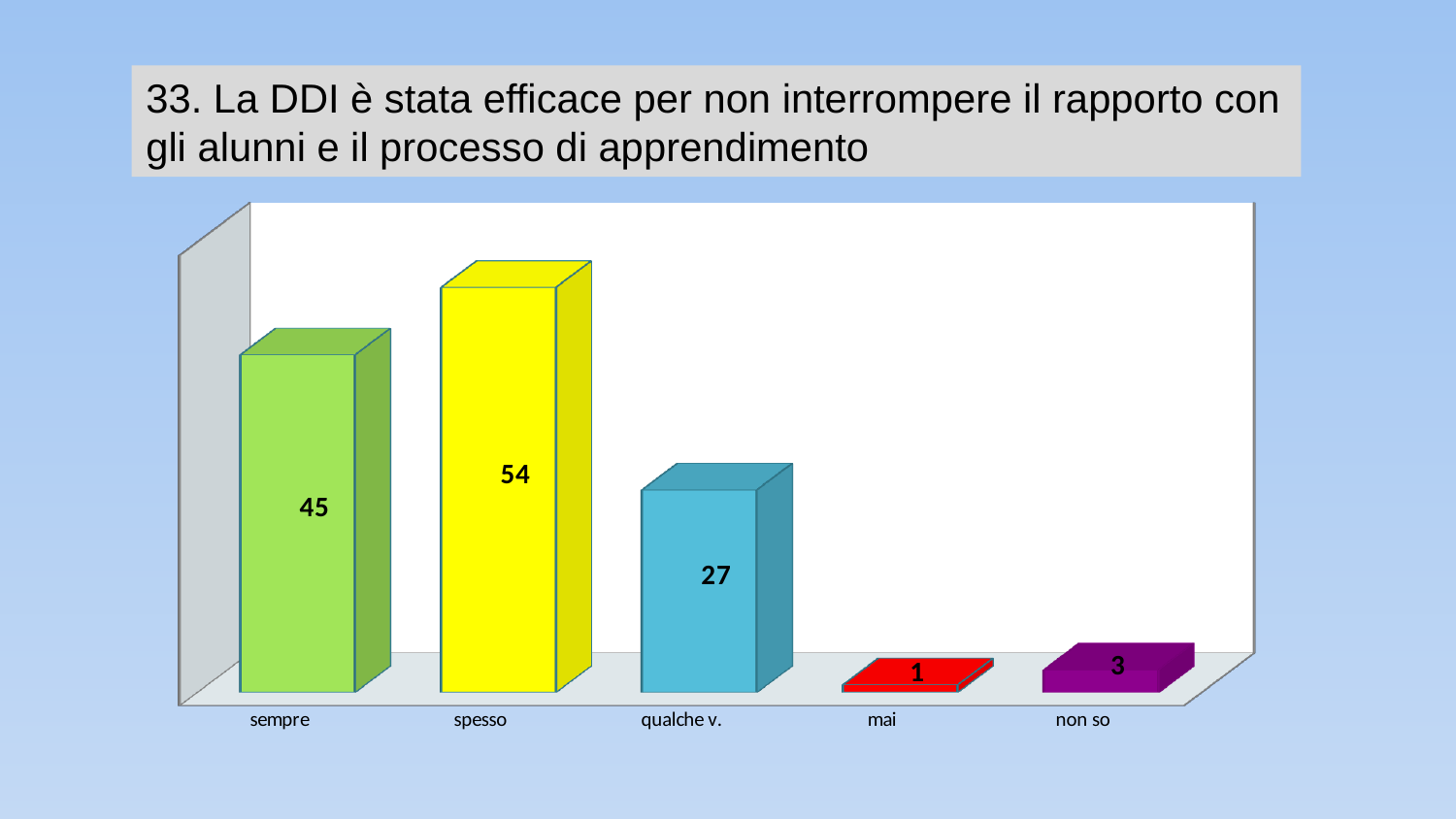
What is the value for "mai"? 1 Which is larger, the value for "sempre" or the value for "qualche v."? sempre What kind of chart is shown on the slide? bar chart What colour is the bar for "spesso"? yellow What is the value for "non so"? 3 What is the value for "spesso"? 54 What is the value for "qualche v."? 27 What is the value for "sempre"? 45 Which category has the highest value? spesso How many categories are shown on the x axis? 5 What is the difference between the values for "spesso" and "sempre"? 9 Which category has the lowest value? mai